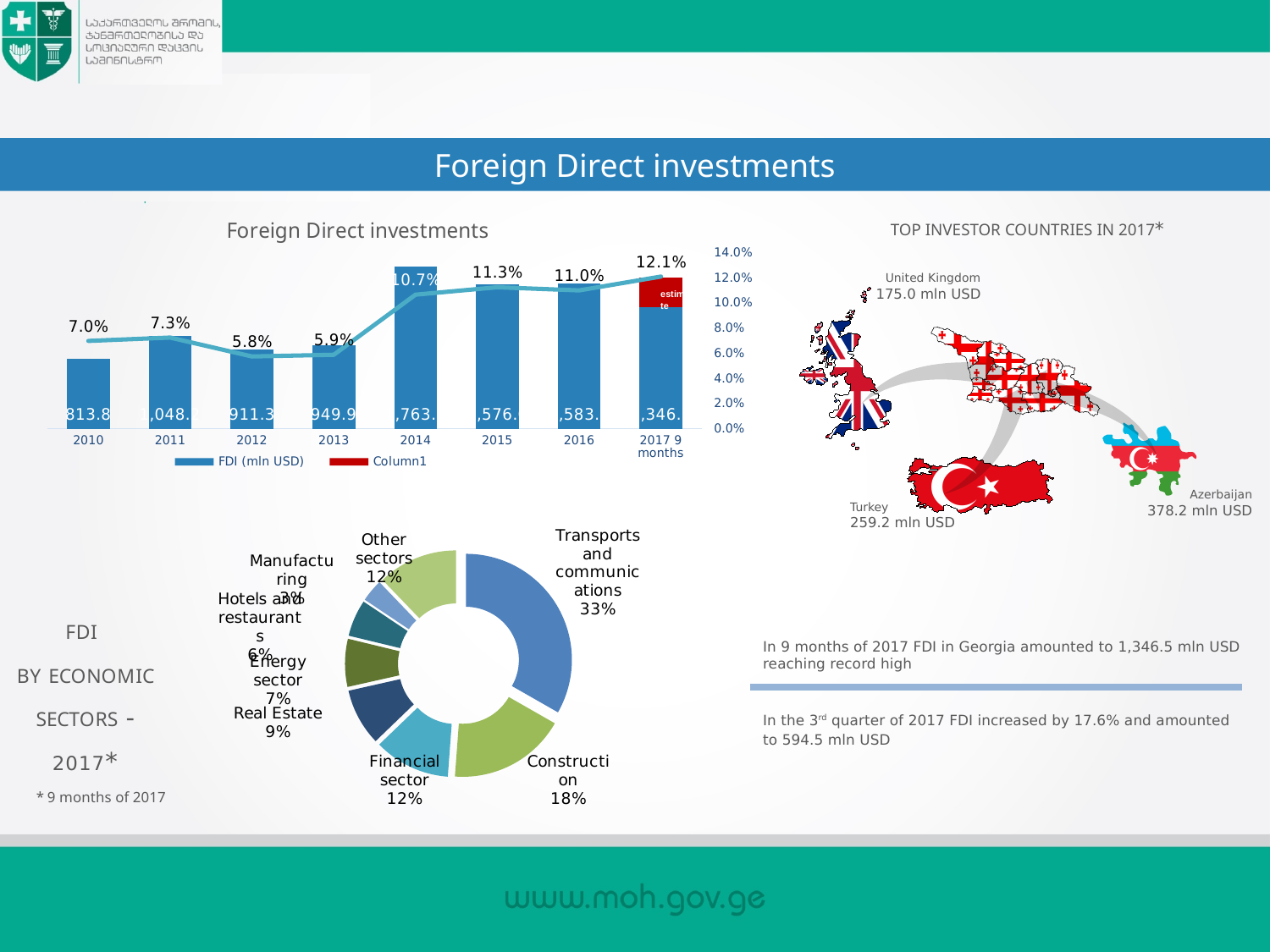
How many entries does the legend of the 'Foreign Direct investments' chart list? 2 In the 'Foreign Direct investments' bar chart, what is the difference between the FDI values for 2013 and 2012? 38.6 In the 'FDI by economic sectors - 2017*' doughnut chart, which sector has the smallest share? Manufacturing In the 'Foreign Direct investments' bar chart, what is the FDI (mln USD) value for 2010? 813.8 In the 'Foreign Direct investments' chart, what percentage is shown on the line for 2014? 10.7% In the 'Foreign Direct investments' chart, which year has the higher line percentage, 2015 or 2016? 2015 In the 'FDI by economic sectors - 2017*' doughnut chart, which sector has the largest share? Transports and communications In the 'Foreign Direct investments' bar chart, what is the FDI (mln USD) value for 2012? 911.3 How many periods are shown on the x axis of the 'Foreign Direct investments' chart? 8 In the 'Foreign Direct investments' chart, which period has the highest percentage on the line? 2017 9 months In the 'Foreign Direct investments' chart, which year has the lowest percentage on the line? 2012 In the 'FDI by economic sectors - 2017*' doughnut chart, what share does Construction have? 18%